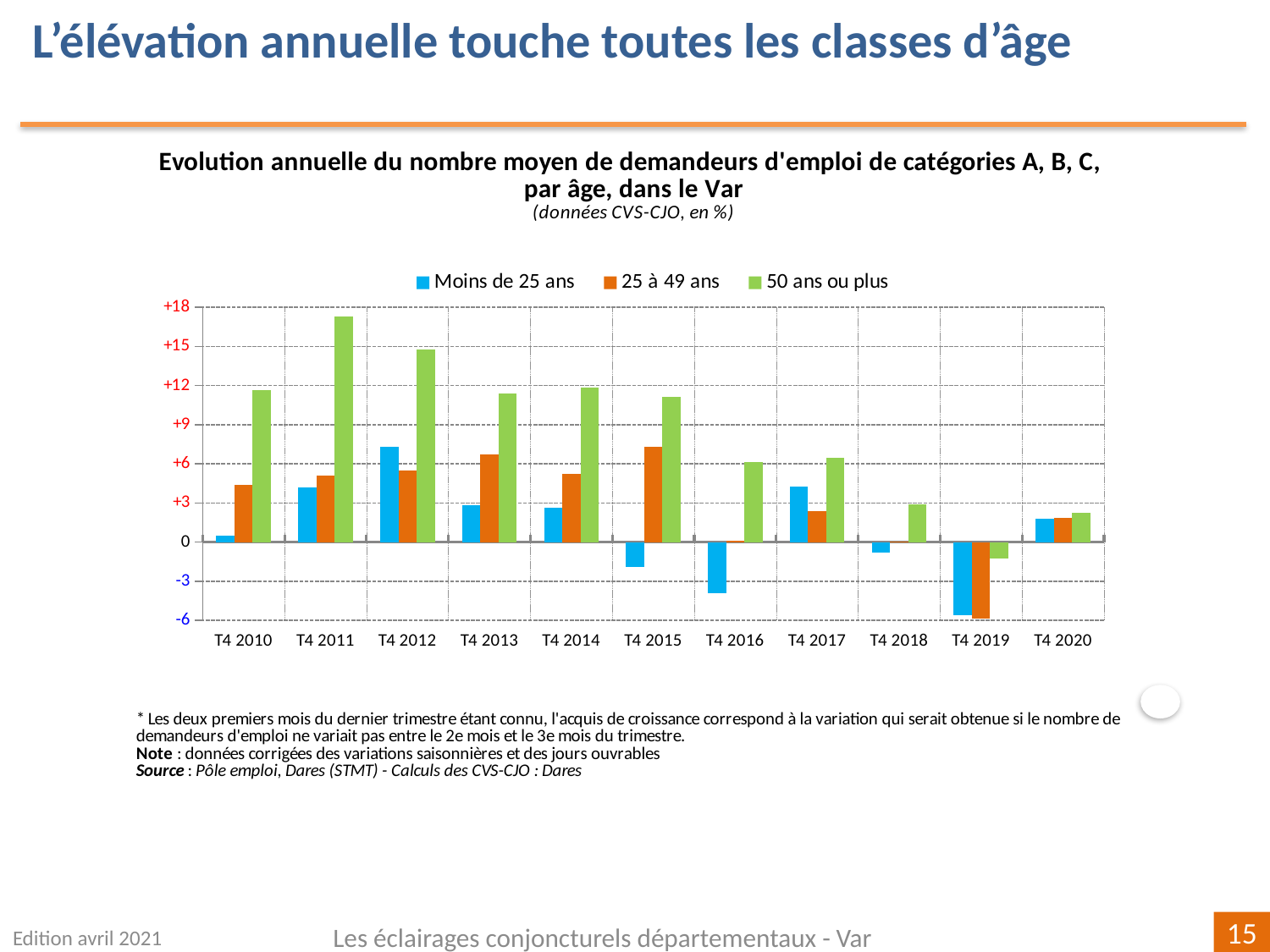
In T4 2012, which is larger: the value for 'Moins de 25 ans' or for '25 à 49 ans'? Moins de 25 ans Do the values for '50 ans ou plus' rise or fall from T4 2015 to T4 2019? fall Is the value for '50 ans ou plus' in T4 2011 greater or less than +15? greater How many series does the legend list? 3 What colour represents the '50 ans ou plus' series in the legend? green In which quarter is the value for '50 ans ou plus' the highest? T4 2011 Is the value for 'Moins de 25 ans' in T4 2016 greater or less than -3? less In T4 2015, which is larger: the value for '25 à 49 ans' or for '50 ans ou plus'? 50 ans ou plus What kind of chart is shown on the slide? bar chart How many quarters (categories) are shown on the x axis? 11 In which quarter is the value for 'Moins de 25 ans' the lowest? T4 2019 Is the value for '25 à 49 ans' in T4 2015 greater or less than +6? greater